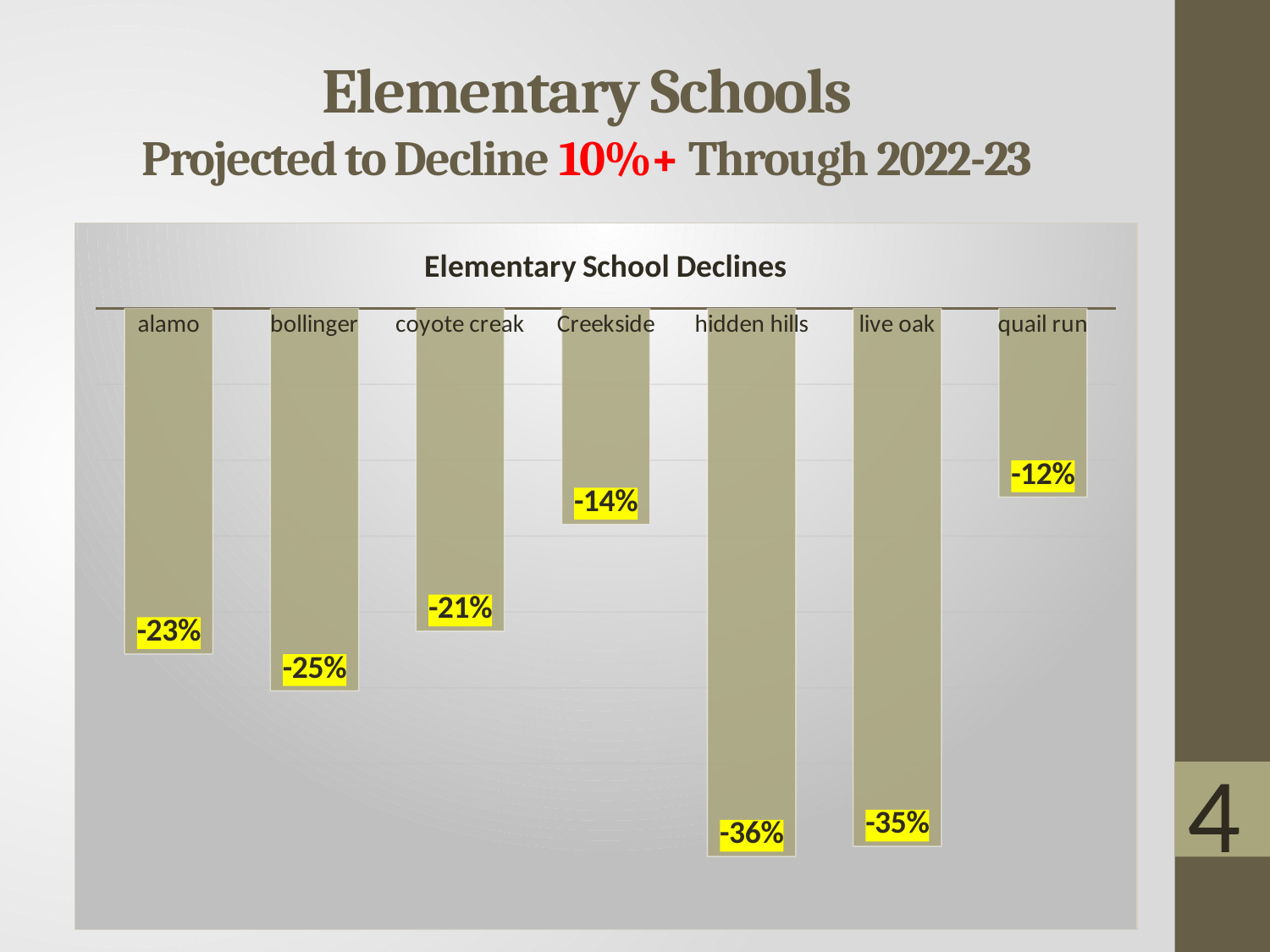
Which school shows the smallest decline in the Elementary School Declines chart? quail run Which school has a larger decline, alamo or Creekside? alamo What is the value for live oak in the Elementary School Declines chart? -35% What is the difference in percentage points between the declines for bollinger and coyote creak? 4 percentage points How many schools are shown in the Elementary School Declines chart? 7 What is the value for alamo in the Elementary School Declines chart? -23% What kind of chart is the Elementary School Declines chart? bar chart What is the value for quail run in the Elementary School Declines chart? -12% Which school shows the largest decline in the Elementary School Declines chart? hidden hills What is the value for hidden hills in the Elementary School Declines chart? -36% What is the title of the chart on the slide? Elementary School Declines What is the value for Creekside in the Elementary School Declines chart? -14%